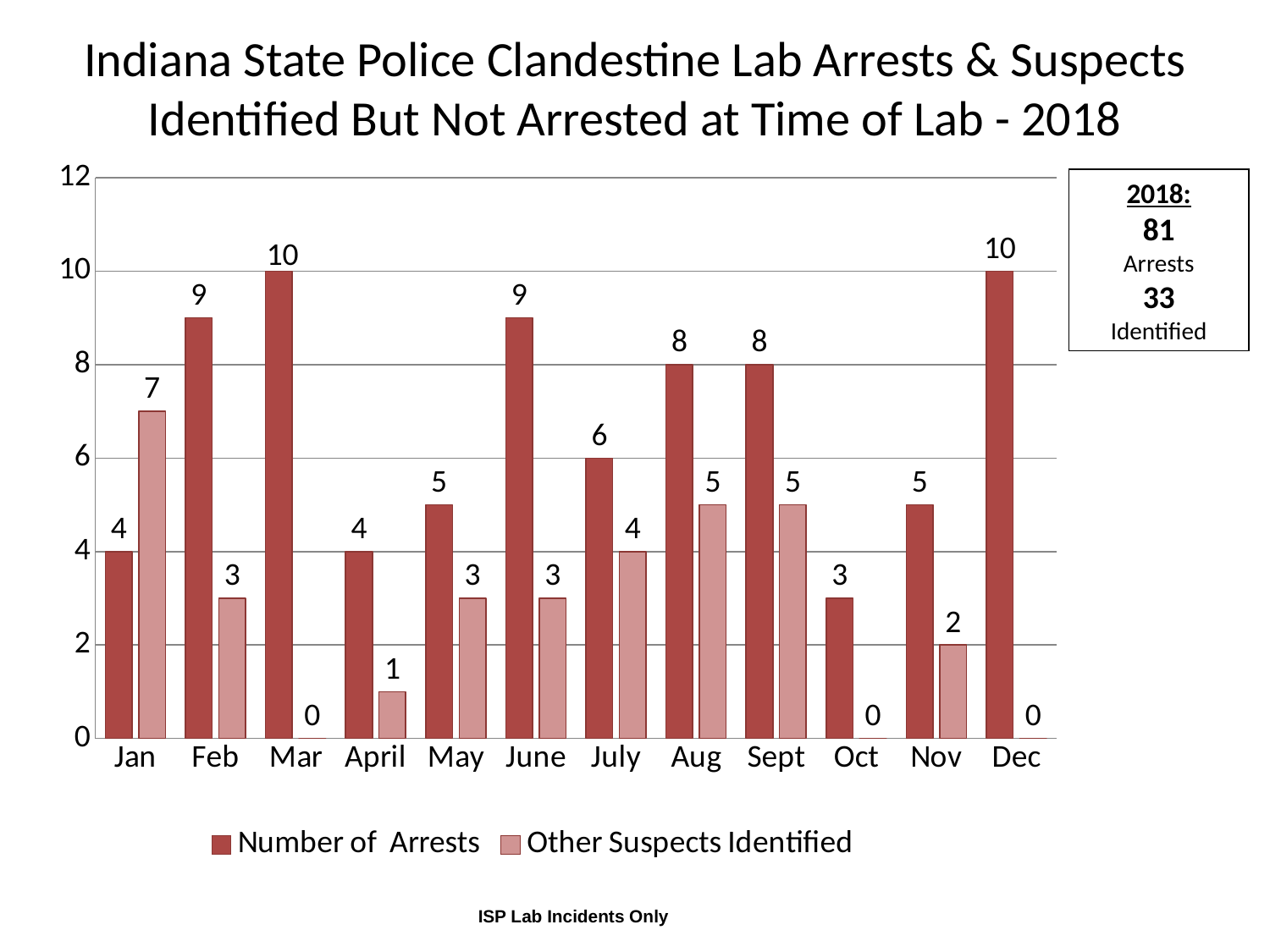
How many Other Suspects Identified are shown for January? 7 Which is larger in January: Number of Arrests or Other Suspects Identified? Other Suspects Identified What is the difference between the Number of Arrests and Other Suspects Identified in February? 6 Which month has the highest value for Other Suspects Identified? Jan What is the Number of Arrests for October? 3 What is the Other Suspects Identified value for November? 2 What is the Number of Arrests for March? 10 How many series does the legend list? 2 How many months are shown on the x axis? 12 Which month has the lowest Number of Arrests? Oct According to the box on the slide, what was the total number of arrests in 2018? 81 What kind of chart is shown on the slide? Bar chart